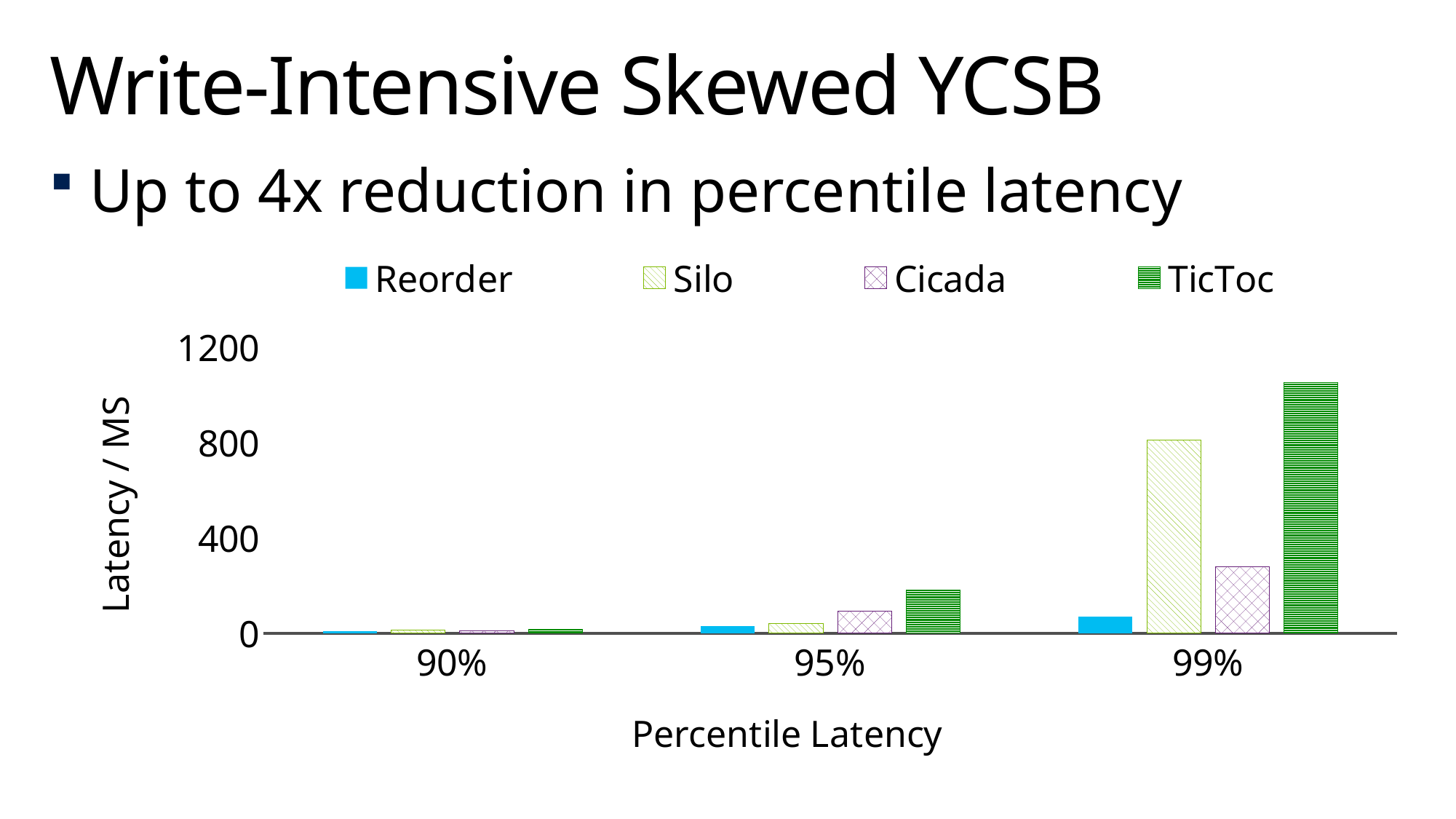
What is the label of the y axis? Latency / MS Which series has the lowest latency at the 99% percentile? Reorder At the 99% percentile, which has the higher latency, Silo or Cicada? Silo Does the latency for TicToc rise or fall as the percentile increases from 90% to 99%? rise Is the value for Silo at 99% greater or less than 400? greater How many series does the legend list? 4 Which series has the highest latency at the 99% percentile? TicToc Is the value for Cicada at 99% greater or less than 400? less Is the value for TicToc at 95% greater or less than 400? less What kind of chart is shown on the slide? bar chart How many percentile categories are shown on the x axis? 3